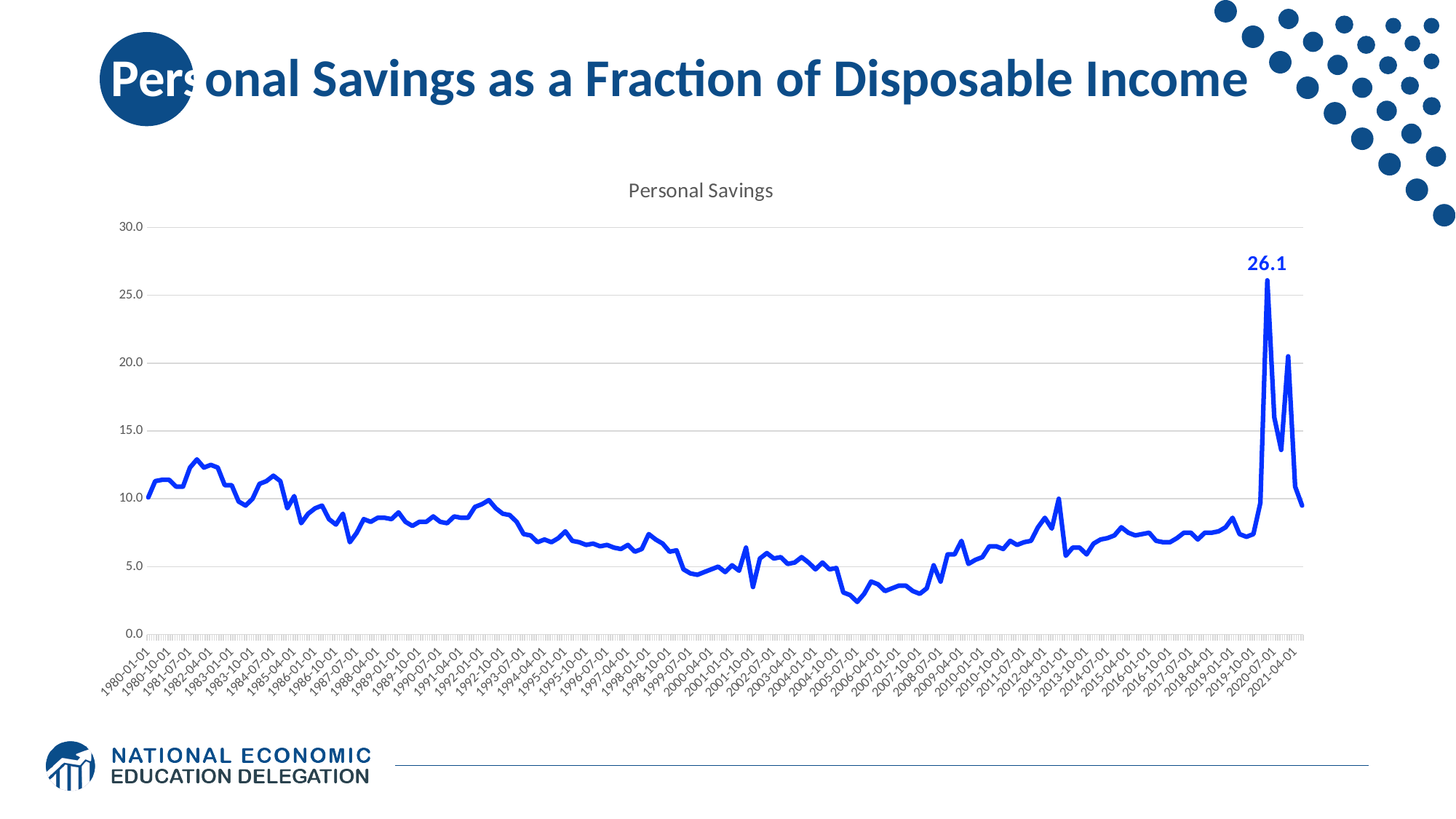
What is the highest value labeled on the line? 26.1 Is the value for 2016-01-01 greater or less than 10.0? less What is the title of the chart? Personal Savings Is the peak value of the line greater or less than 25.0? greater What is the highest tick value shown on the y axis? 30.0 Does the line generally rise or fall between 1980-01-01 and 2005-07-01? fall What is the first date label on the x axis? 1980-01-01 Is the value for 1982-04-01 greater or less than 10.0? greater What kind of chart is shown on the slide? line chart Which is larger, the value for 1982-04-01 or the value for 2005-07-01? 1982-04-01 Which is larger, the value for 2020-07-01 or the value for 1980-01-01? 2020-07-01